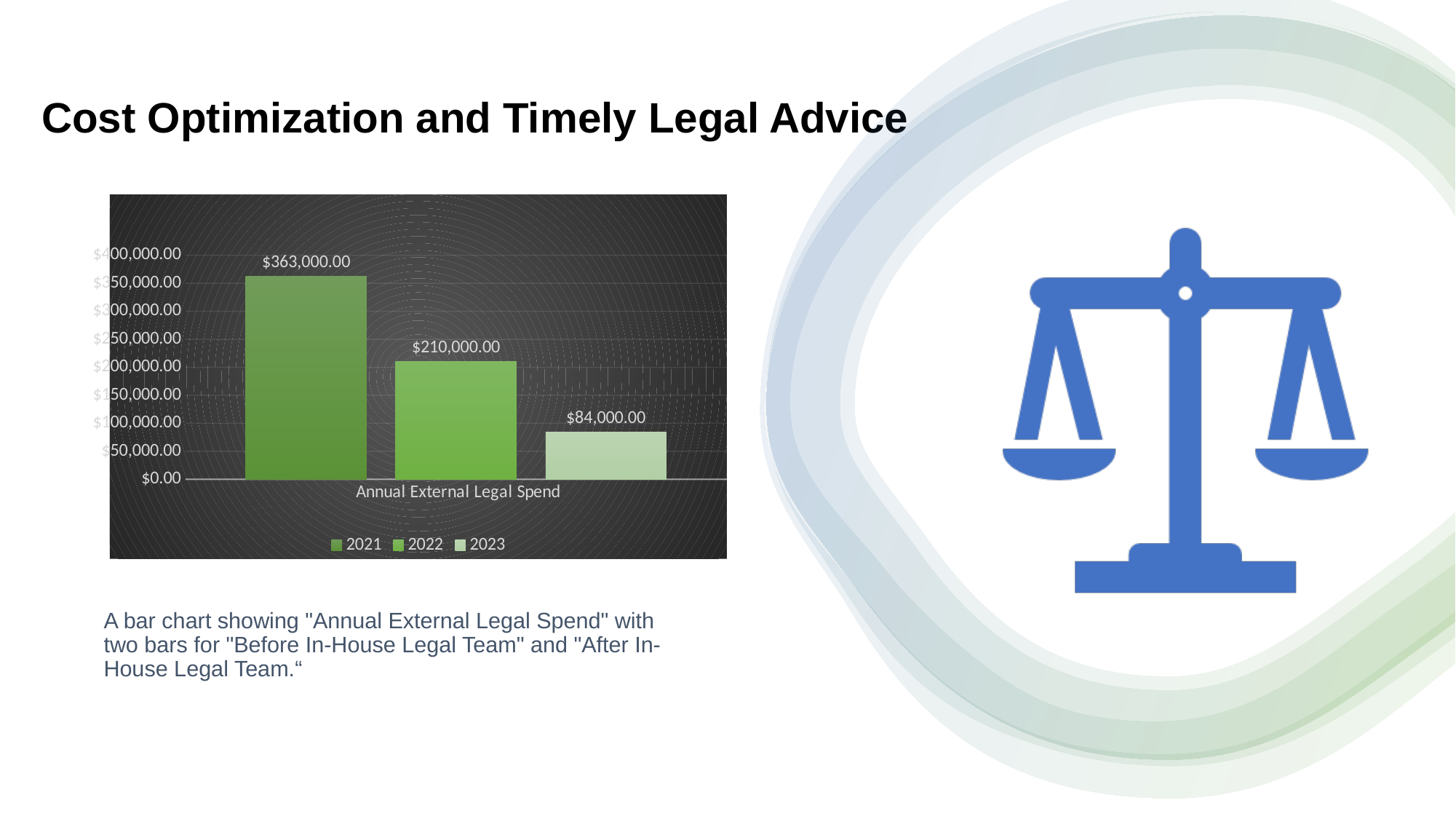
Which year has the highest Annual External Legal Spend? 2021 How many series does the chart legend list? 3 What is the value for 2023 in the Annual External Legal Spend chart? $84,000.00 What is the difference between the 2022 and 2023 values in the chart? $126,000.00 Do the values rise or fall from 2021 to 2023? fall Is the value for 2023 greater or less than $100,000.00? less What is the value for 2022 in the Annual External Legal Spend chart? $210,000.00 What is the difference between the 2021 and 2022 values in the chart? $153,000.00 What kind of chart is shown on the slide? bar chart What is the value for 2021 in the Annual External Legal Spend chart? $363,000.00 Which year has the lowest Annual External Legal Spend? 2023 Which is larger, the value for 2022 or the value for 2023? 2022